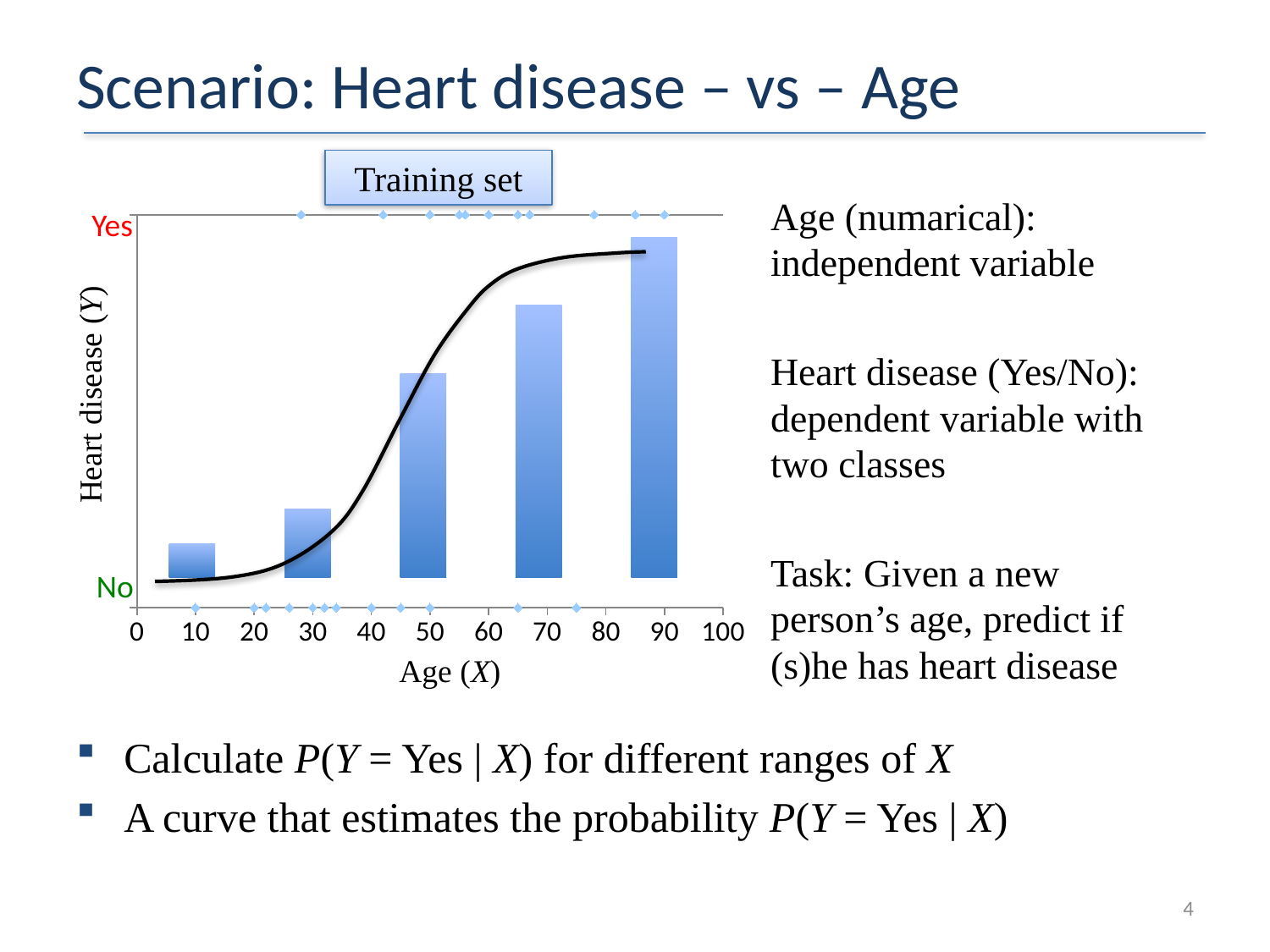
What is the label of the y axis of the chart? Heart disease (Y) Is the bar around age 50 taller or shorter than the bar around age 30? taller What is the label of the x axis of the chart? Age (X) Which bar is the tallest in the chart? the bar around age 90 What kind of chart is shown on the slide? bar chart Which bar is the shortest in the chart? the bar around age 10 How many bars are plotted in the chart? 5 Do the bar heights rise or fall as age increases along the x axis? rise Is the bar around age 70 taller or shorter than the bar around age 90? shorter What is the highest tick value shown on the x axis? 100 What are the two category labels shown on the y axis? Yes and No